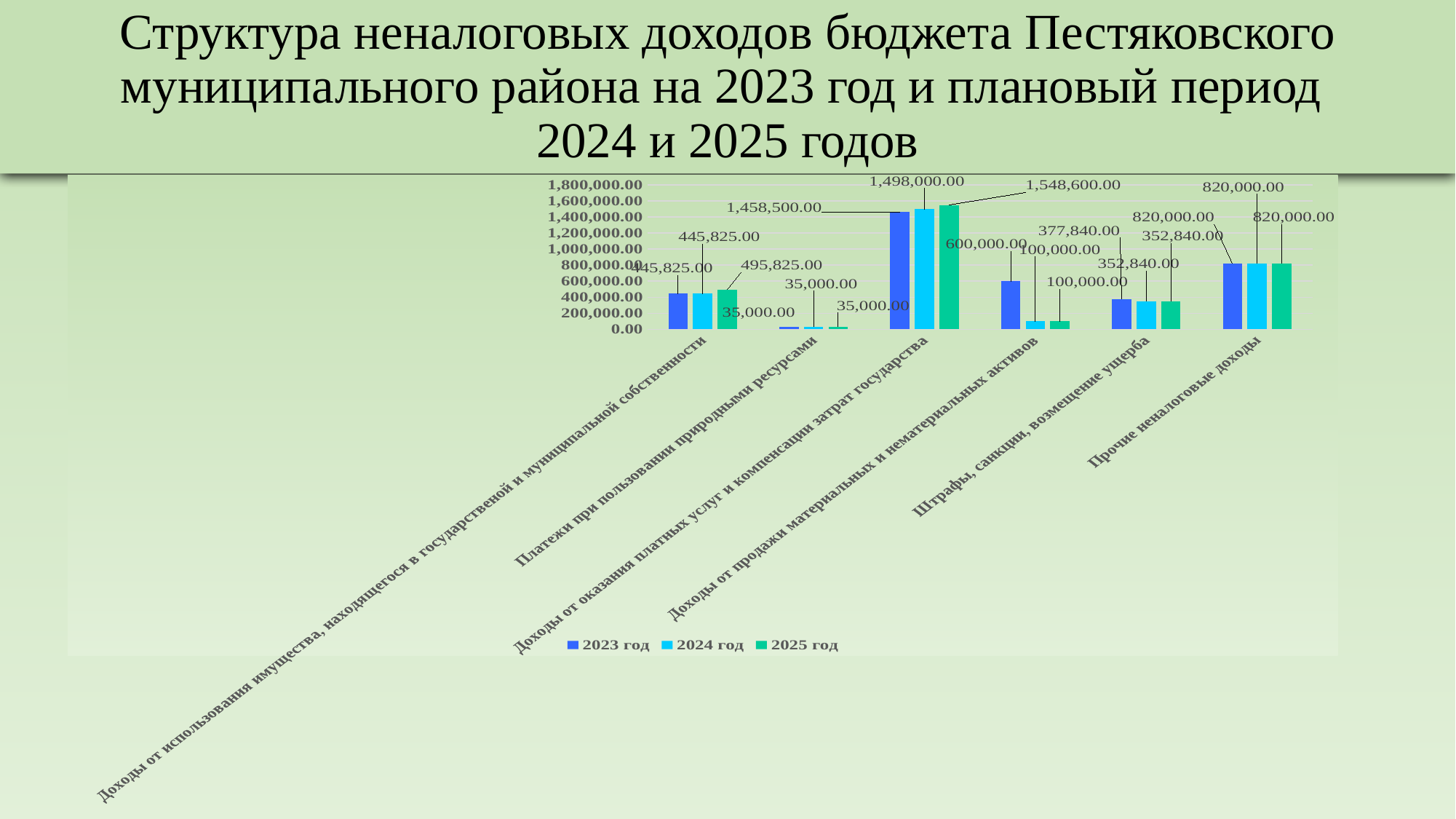
What is the 2024 год value for Прочие неналоговые доходы? 820,000.00 Which category has the highest 2024 год value? Доходы от оказания платных услуг и компенсации затрат государства Is the 2023 год value for Прочие неналоговые доходы greater or less than 1,000,000.00? less What kind of chart is shown on the slide? bar chart Which category has the lowest 2023 год value? Платежи при пользовании природными ресурсами What is the 2023 год value for Доходы от продажи материальных и нематериальных активов? 600,000.00 What is the 2025 год value for Доходы от оказания платных услуг и компенсации затрат государства? 1,548,600.00 Which is larger for Доходы от продажи материальных и нематериальных активов: the 2023 год value or the 2024 год value? 2023 год What is the difference between the 2025 год and 2023 год values for Доходы от оказания платных услуг и компенсации затрат государства? 90,100.00 How many series does the legend list? 3 How many categories are shown on the x axis? 6 What is the 2025 год value for Доходы от использования имущества, находящегося в государственной и муниципальной собственности? 495,825.00